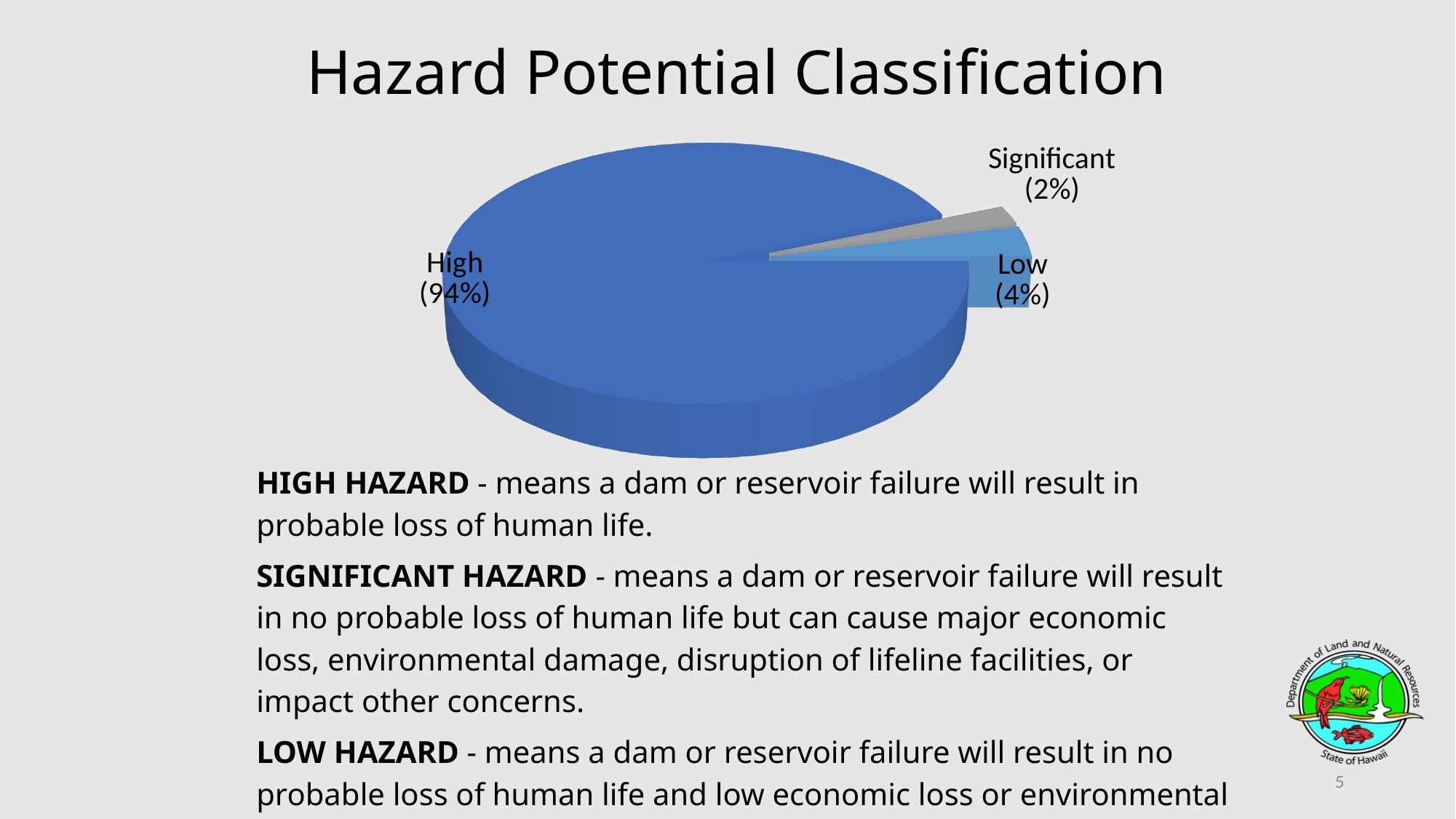
What is the title of the slide containing the pie chart? Hazard Potential Classification Which is larger, the Low slice or the Significant slice? Low What colour is the High slice of the pie chart? blue Which category has the smallest slice of the pie? Significant What share of the pie does the Significant category have? 2% What share of the pie does the Low category have? 4% How many categories are shown in the pie chart? 3 What is the difference in percentage points between the Low and Significant slices? 2 What type of chart is shown on the slide? pie chart What is the difference in percentage points between the High and Low slices? 90 Which category has the largest slice of the pie? High What share of the pie does the High category have? 94%